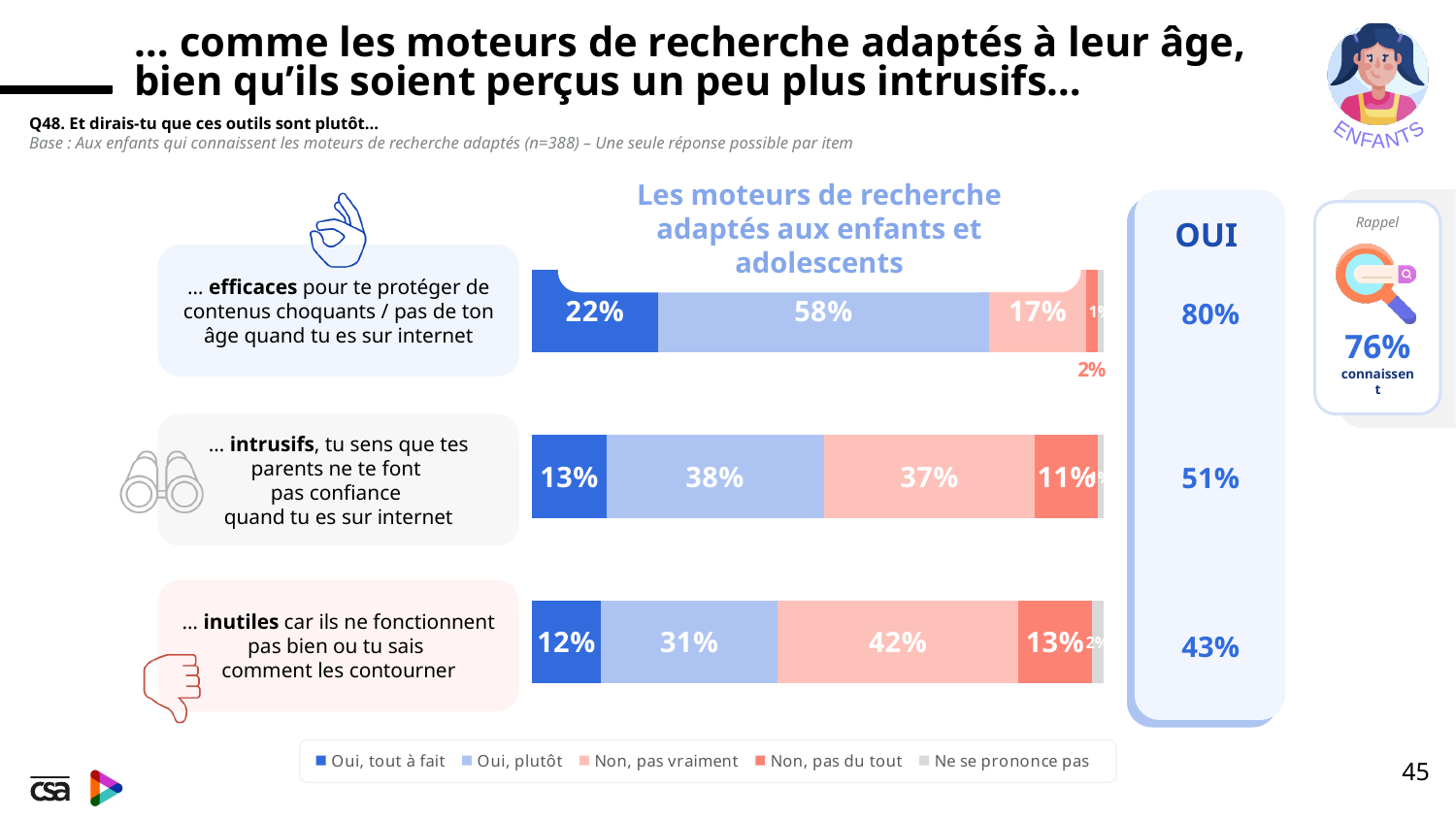
Which is larger: the 'Non, pas vraiment' value for 'intrusifs' or for 'inutiles'? inutiles Which item has the highest 'Oui, tout à fait' value? … efficaces pour te protéger de contenus choquants What is the 'Non, pas du tout' value for the item '… inutiles car ils ne fonctionnent pas bien'? 13% What is the difference between the 'Oui, plutôt' values for the 'efficaces' item and the 'intrusifs' item? 20 points What is the 'Non, pas vraiment' value for the item '… inutiles car ils ne fonctionnent pas bien'? 42% Which item has the lowest total 'OUI' share? … inutiles car ils ne fonctionnent pas bien What type of chart is shown on the slide? stacked bar chart What is the 'Oui, tout à fait' value for the item '… efficaces pour te protéger de contenus choquants'? 22% How many items (categories) are plotted in the chart? 3 What is the 'Non, pas vraiment' value for the item '… intrusifs, tu sens que tes parents ne te font pas confiance'? 37% How many series does the legend list? 5 What is the 'Oui, plutôt' value for the item '… efficaces pour te protéger de contenus choquants'? 58%